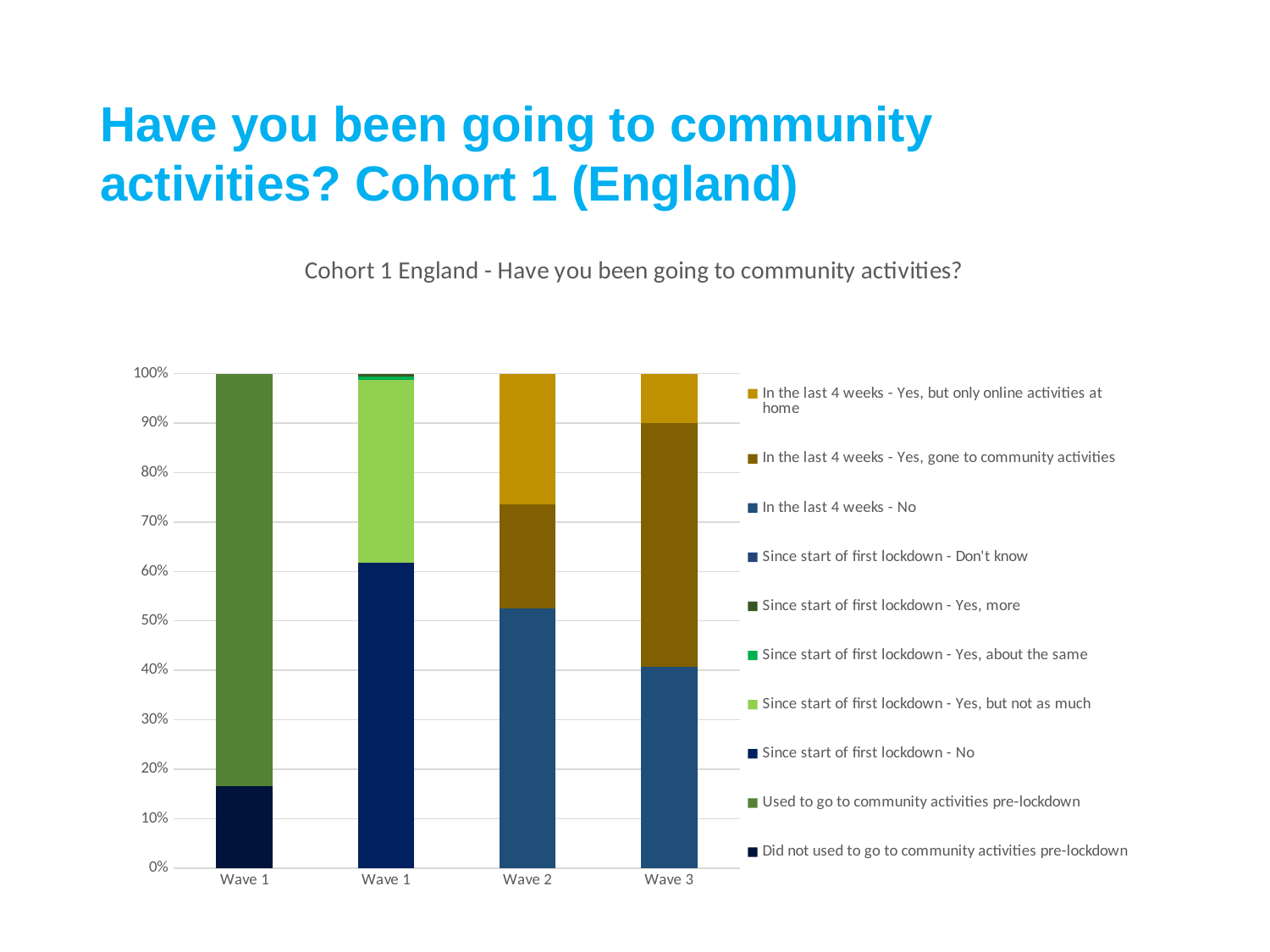
How many bars are plotted along the x axis of the chart? 4 Is the 'In the last 4 weeks - No' segment larger for Wave 2 or for Wave 3? Wave 2 Is the 'In the last 4 weeks - No' segment for Wave 2 greater or less than 50%? greater What kind of chart is shown on the slide? Stacked bar chart Is the 'Since start of first lockdown - No' segment in the second Wave 1 bar greater or less than 50%? greater Is the 'In the last 4 weeks - Yes, but only online activities at home' segment for Wave 3 greater or less than 20%? less How many series does the chart's legend list? 10 Does the 'In the last 4 weeks - Yes, but only online activities at home' segment rise or fall from Wave 2 to Wave 3? Fall What is the total height of the Wave 2 stacked bar? 100% What is the title of the chart? Cohort 1 England - Have you been going to community activities? Is the 'In the last 4 weeks - Yes, gone to community activities' segment larger for Wave 2 or for Wave 3? Wave 3